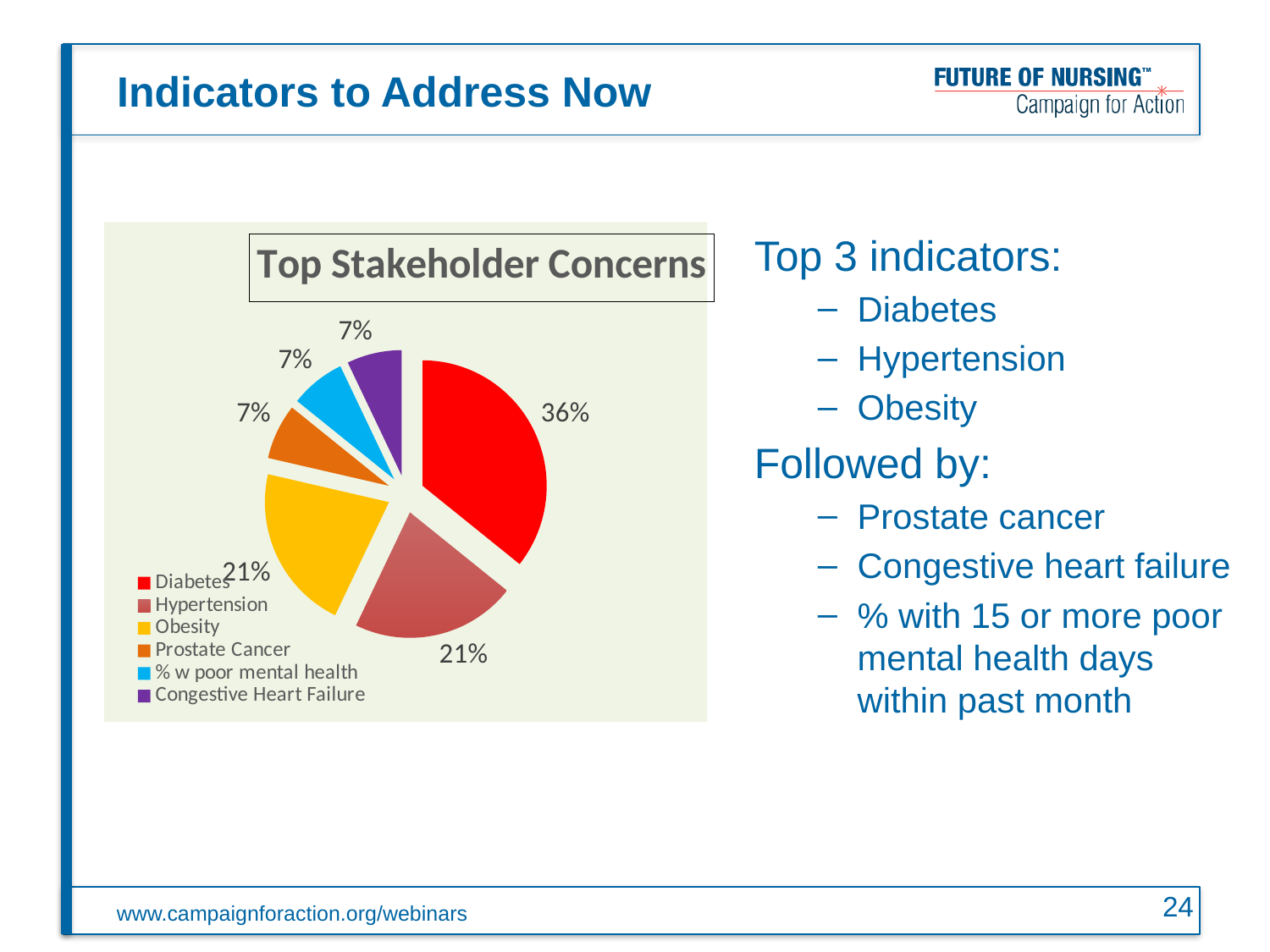
Which category has the largest slice of the pie? Diabetes What share of the pie does Prostate Cancer represent? 7% What share of the pie does Hypertension represent? 21% What colour is the Diabetes slice? Red How many categories does the legend list? 6 What share of the pie does Congestive Heart Failure represent? 7% Which is larger, the share for Obesity or the share for Prostate Cancer? Obesity What share of the pie does Obesity represent? 21% What share of the pie does Diabetes represent? 36% What is the difference between the Diabetes share and the Hypertension share? 15% What type of chart is shown on the slide? Pie chart What is the title of the chart? Top Stakeholder Concerns